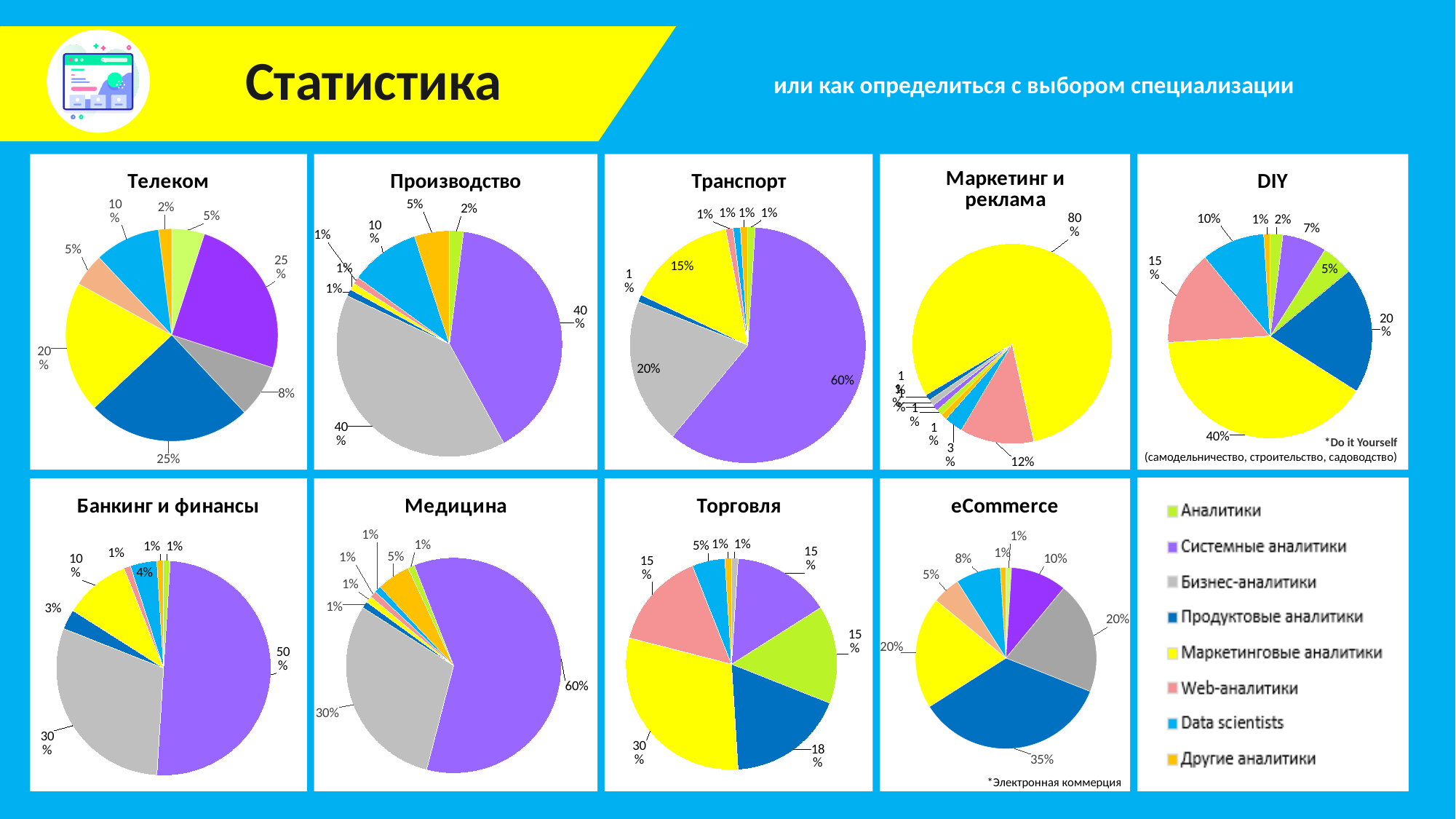
How many categories does the legend list? 8 How many pie charts are shown on the slide? 9 In the eCommerce chart, which category has the largest share? Продуктовые аналитики In the Банкинг и финансы chart, what is the difference between the shares of Системные аналитики and Бизнес-аналитики? 20% In the Маркетинг и реклама chart, which category has the largest share? Маркетинговые аналитики What type of chart is used for Телеком? Pie chart In the Медицина chart, which is larger: the share of Системные аналитики or Бизнес-аналитики? Системные аналитики In the Телеком chart, what share do Системные аналитики have? 25% In the Торговля chart, what is the share of Продуктовые аналитики? 18% In the DIY chart, what share do Маркетинговые аналитики have? 40% In the Транспорт chart, what share do Системные аналитики have? 60% In the Производство chart, what share do Data scientists have? 10%